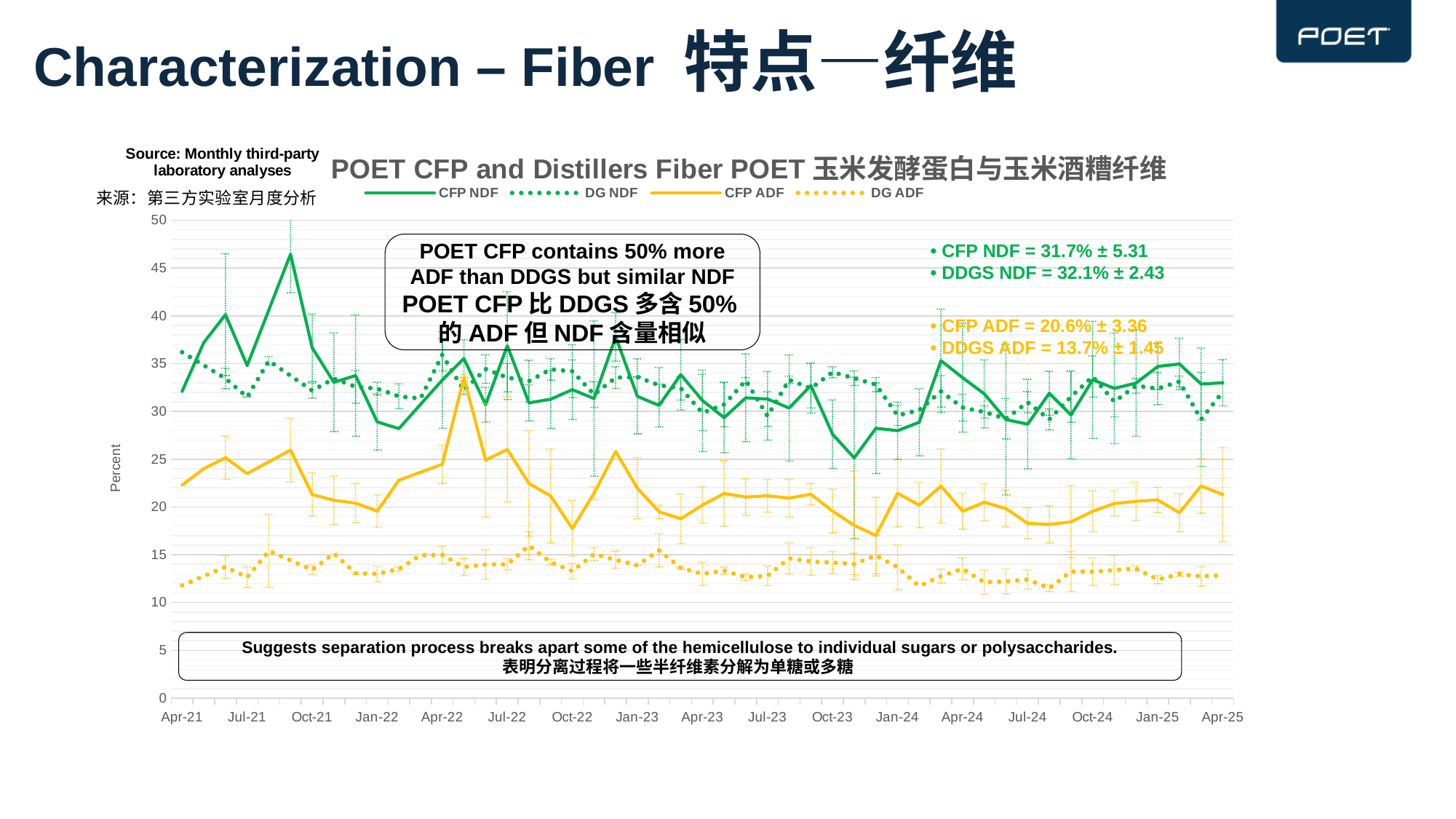
Which of the four series has the lowest values across the whole chart? DG ADF How many series does the legend of the chart list? 4 What is the label of the vertical axis of the chart? Percent Is the highest value reached by CFP NDF greater or less than 40? greater According to the annotation on the chart, what is the mean CFP NDF value? 31.7% ± 5.31 Is the value for DG ADF at Apr-21 greater or less than 15? less What is the difference between the annotated mean CFP ADF (20.6%) and mean DDGS ADF (13.7%)? 6.9 percentage points At Apr-21, which is larger: CFP ADF or DG ADF? CFP ADF According to the annotation on the chart, what is the mean DDGS ADF value? 13.7% ± 1.45 What are the four series listed in the chart legend? CFP NDF, DG NDF, CFP ADF, DG ADF According to the annotation on the chart, what is the mean CFP ADF value? 20.6% ± 3.36 What kind of chart is shown on the slide? Line chart